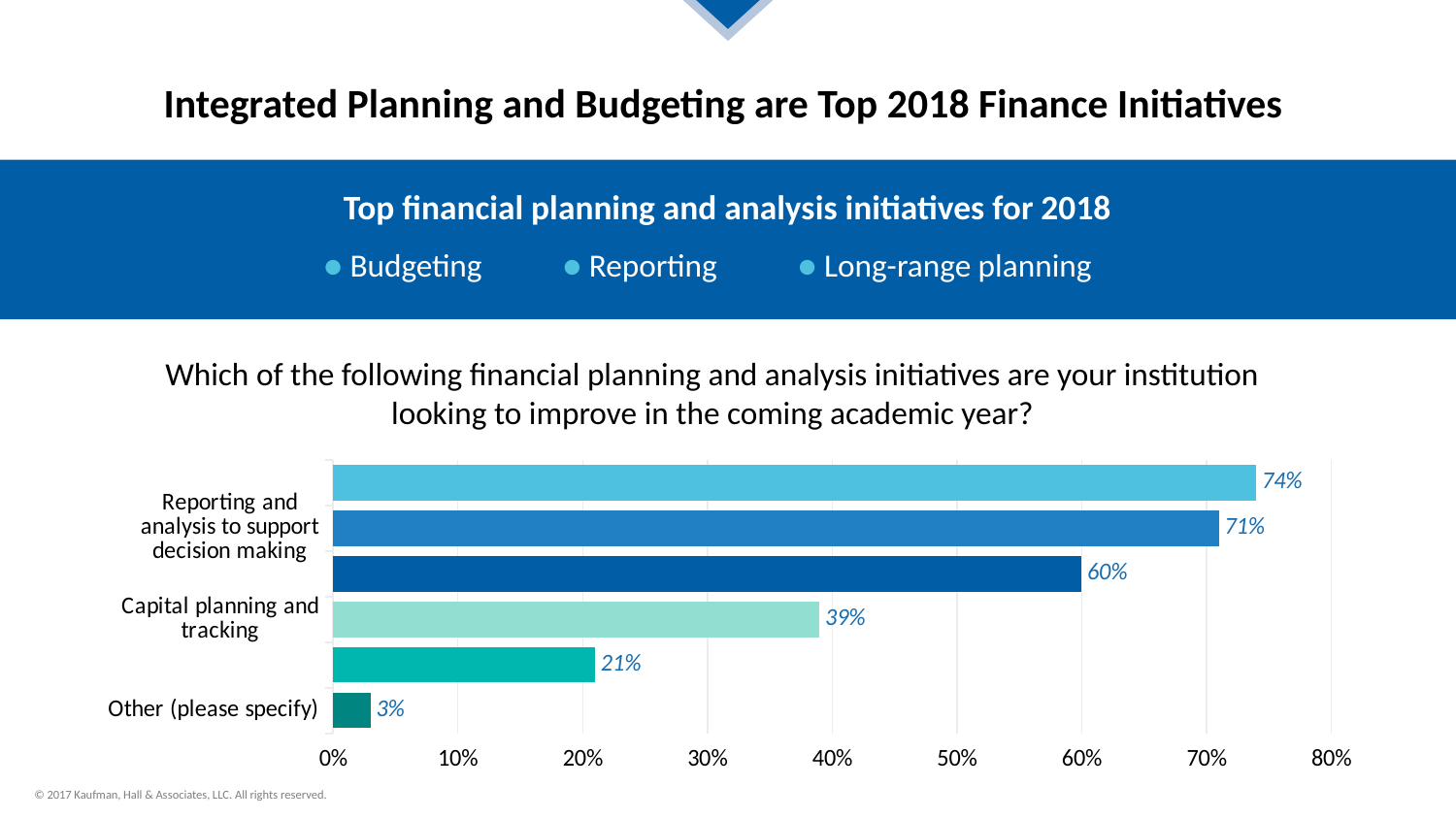
What is the highest value shown on any bar in the chart? 74% What is the difference between the top bar (74%) and the second bar (71%)? 3% Is the value for "Capital planning and tracking" greater or less than 40%? less What is the lowest value shown on any bar in the chart? 3% What kind of chart is shown on the slide? bar chart What question is the chart answering, as written above it? Which of the following financial planning and analysis initiatives are your institution looking to improve in the coming academic year? Which is larger: the value for "Capital planning and tracking" or the value for "Other (please specify)"? Capital planning and tracking How many bars are plotted in the chart? 6 What is the value shown for "Capital planning and tracking"? 39% What is the highest value labelled on the horizontal axis of the chart? 80% What is the value shown for "Other (please specify)"? 3% What is the difference between the value for "Capital planning and tracking" and the value for "Other (please specify)"? 36%